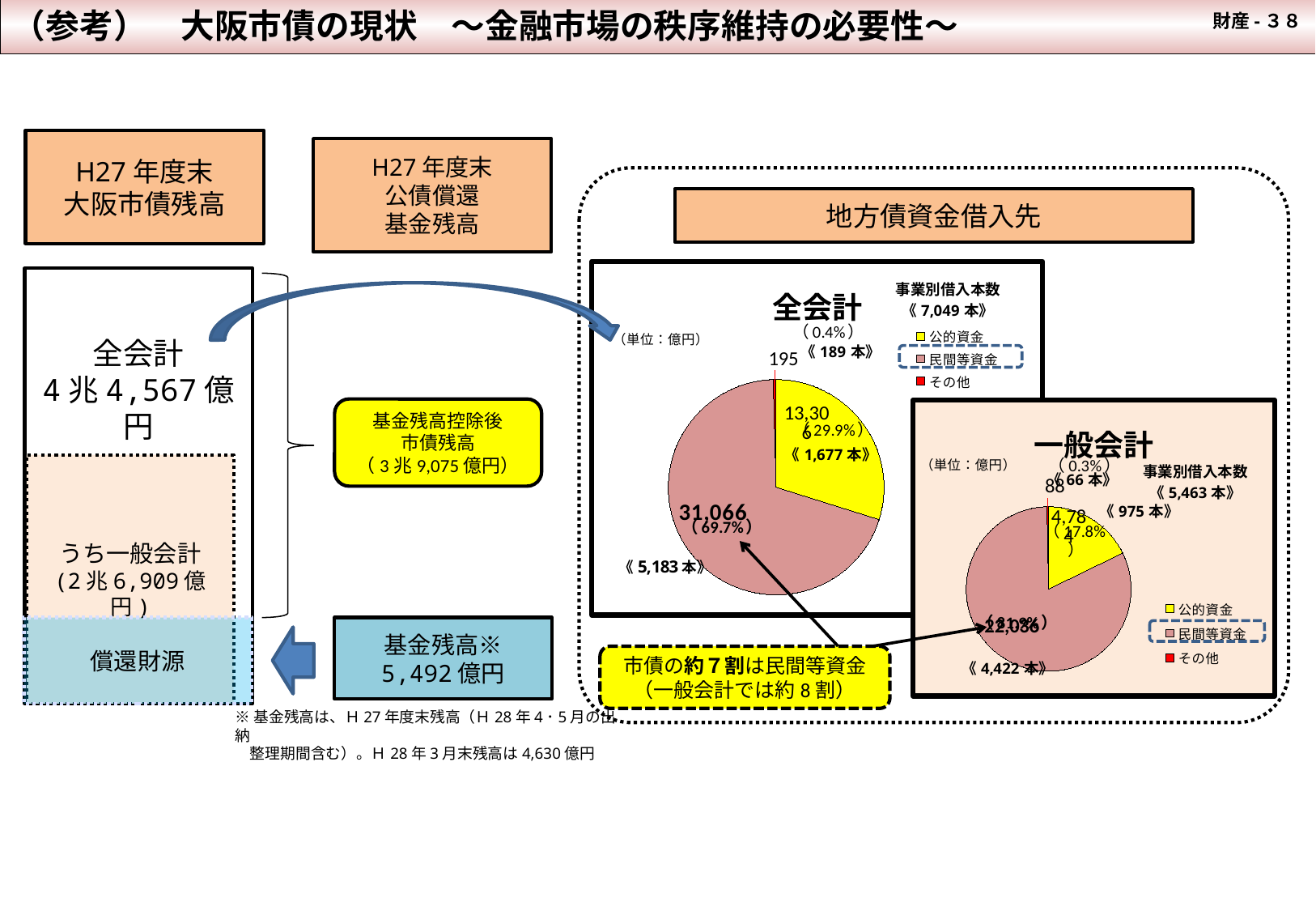
In the 全会計 pie chart, what share does 民間等資金 hold? 69.7% What kind of chart is the 全会計 chart? pie chart In the 一般会計 pie chart, what share does 公的資金 hold? 17.8% In the 一般会計 pie chart, what is the value for その他? 88 In the 全会計 pie chart, which category has the smallest slice? その他 In the 一般会計 pie chart, which category has the largest slice? 民間等資金 In the 全会計 pie chart, which category has the largest slice? 民間等資金 In the 全会計 pie chart, what is the difference between the values for 民間等資金 and その他? 30,871 In the 全会計 pie chart, what is the value for その他? 195 How many categories does the legend of the 全会計 pie chart list? 3 In the 全会計 pie chart, what share does その他 hold? 0.4% In the 全会計 pie chart, what is the value for 民間等資金? 31,066